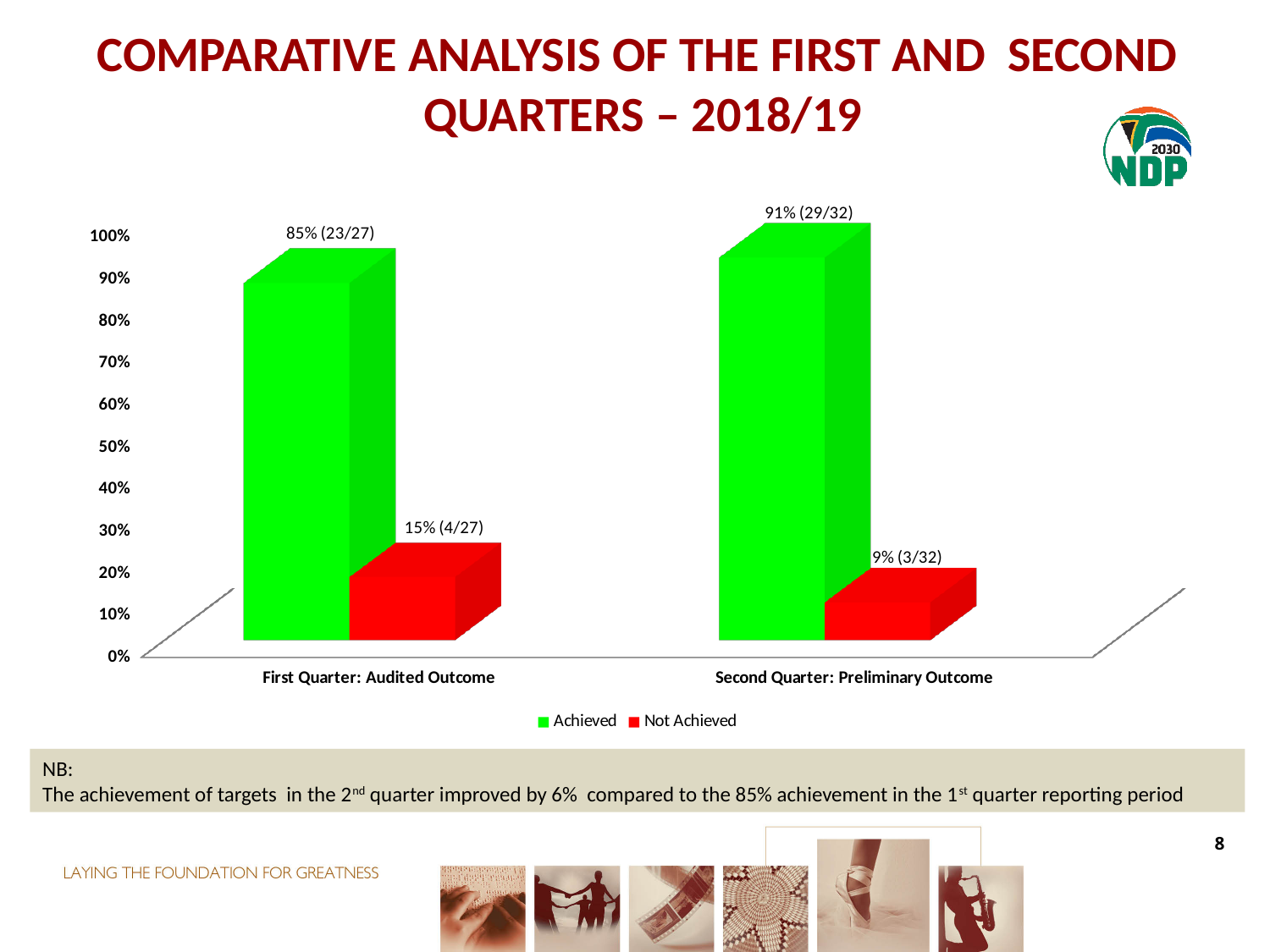
Which category has the lowest Not Achieved percentage? Second Quarter: Preliminary Outcome What kind of chart is shown on the slide? Bar chart Is the Achieved percentage larger for the First Quarter or the Second Quarter? Second Quarter What is the Achieved value for First Quarter: Audited Outcome? 85% (23/27) What is the Not Achieved value for Second Quarter: Preliminary Outcome? 9% (3/32) Which colour represents the Not Achieved series? Red Which category has the highest Achieved percentage? Second Quarter: Preliminary Outcome How many series does the legend list? 2 What is the difference in Achieved percentage between the Second Quarter and the First Quarter? 6% What is the Not Achieved value for First Quarter: Audited Outcome? 15% (4/27) What is the Achieved value for Second Quarter: Preliminary Outcome? 91% (29/32) How many categories are shown on the x axis? 2